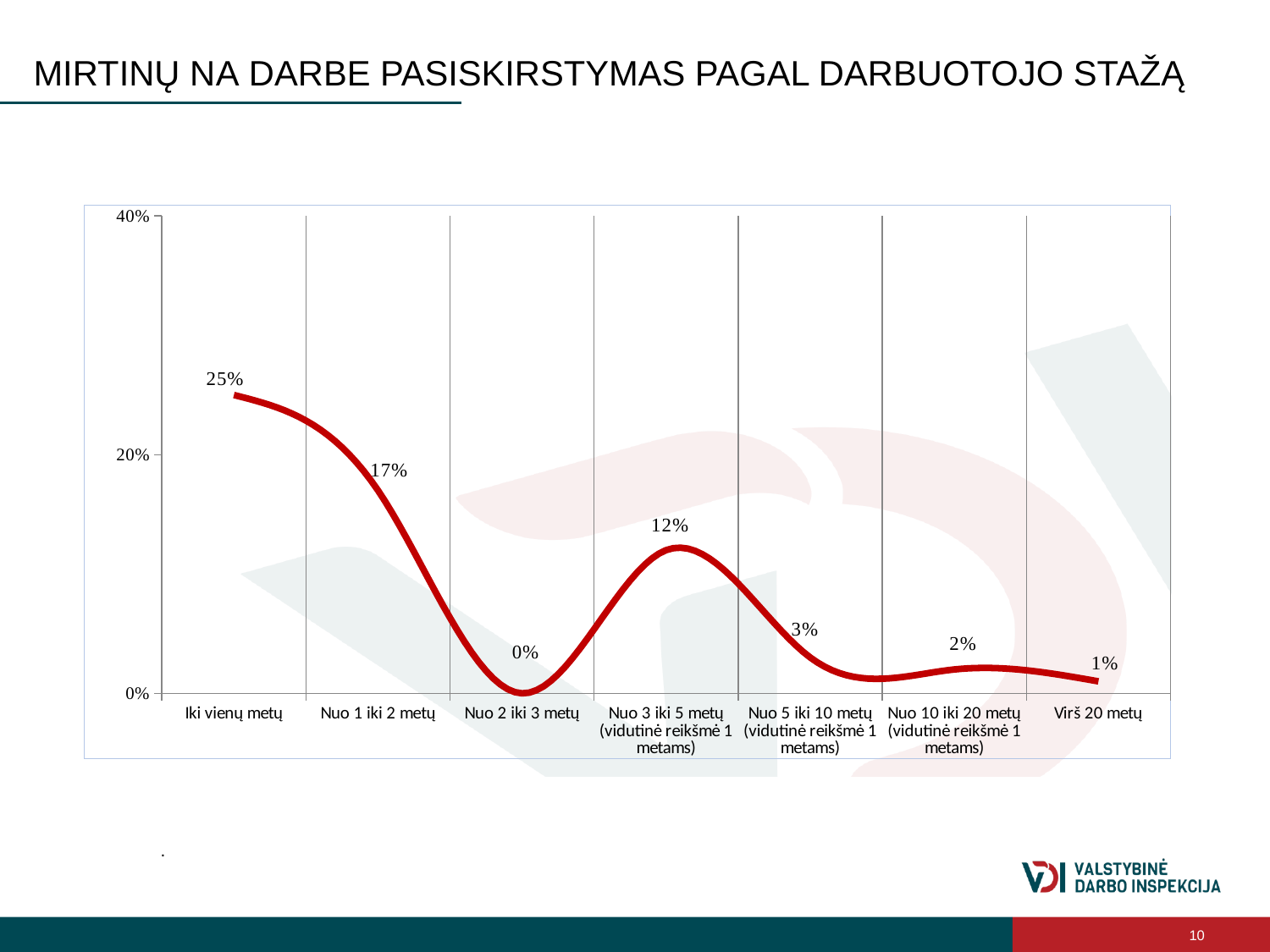
Which category has the lowest value? Nuo 2 iki 3 metų What kind of chart is shown on the slide? Line chart Which category has the highest value? Iki vienų metų Which is larger, the value for "Nuo 5 iki 10 metų (vidutinė reikšmė 1 metams)" or "Nuo 10 iki 20 metų (vidutinė reikšmė 1 metams)"? Nuo 5 iki 10 metų (vidutinė reikšmė 1 metams) What is the value for "Iki vienų metų"? 25% What is the value for "Nuo 3 iki 5 metų (vidutinė reikšmė 1 metams)"? 12% How many categories are shown on the x axis? 7 Is the value for "Iki vienų metų" greater or less than 20%? greater What is the title of the slide? MIRTINŲ NA DARBE PASISKIRSTYMAS PAGAL DARBUOTOJO STAŽĄ What is the value for "Nuo 1 iki 2 metų"? 17% What is the value for "Virš 20 metų"? 1% What is the difference between the values for "Iki vienų metų" and "Nuo 1 iki 2 metų"? 8%